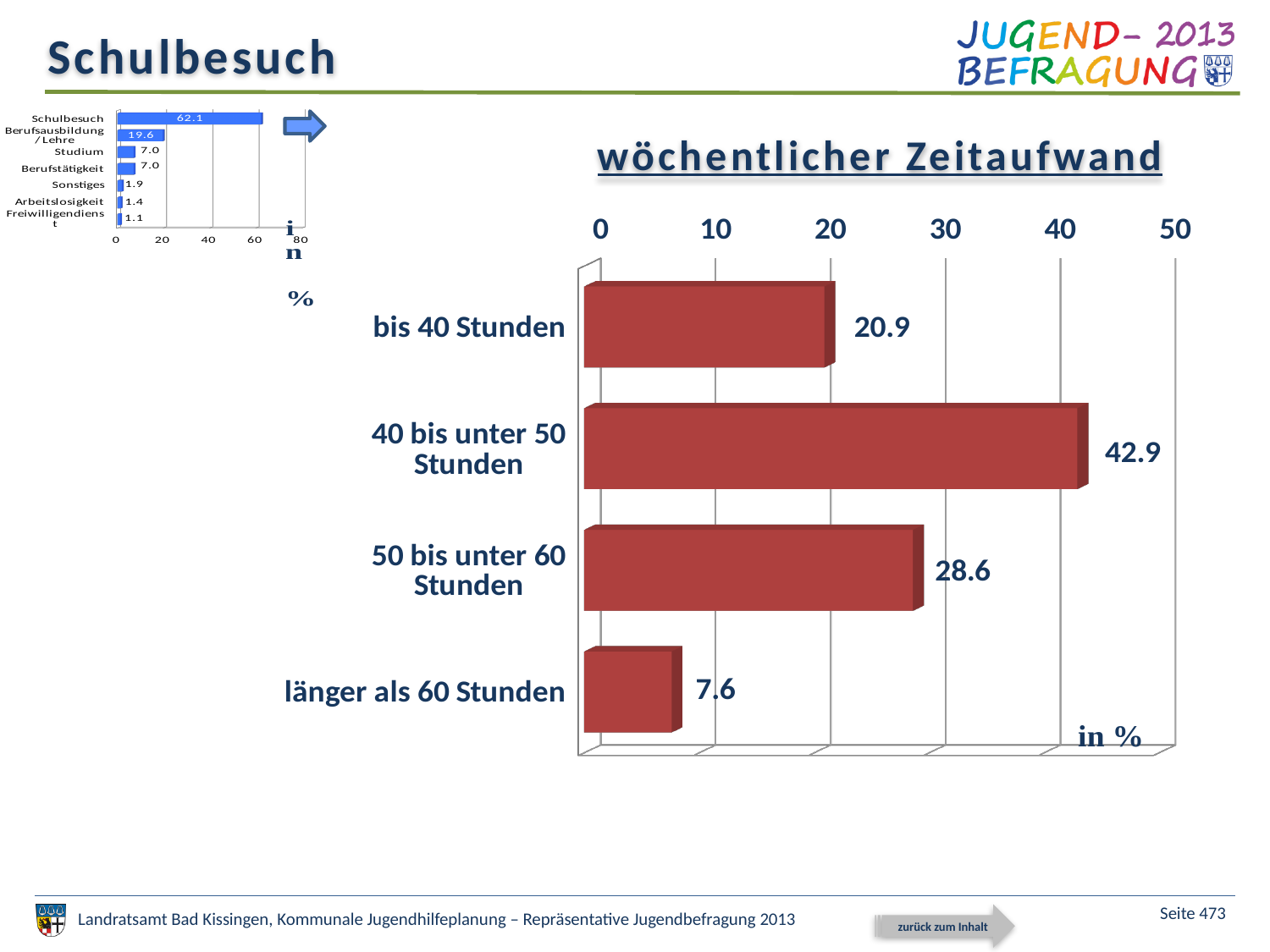
In the 'wöchentlicher Zeitaufwand' chart, what is the value for 'länger als 60 Stunden'? 7.6 In the 'wöchentlicher Zeitaufwand' chart, what is the value for '40 bis unter 50 Stunden'? 42.9 In the 'wöchentlicher Zeitaufwand' chart, which is larger: 'bis 40 Stunden' or '50 bis unter 60 Stunden'? 50 bis unter 60 Stunden In the small chart at the top left of the slide, what is the value for 'Berufsausbildung/Lehre'? 19.6 In the 'wöchentlicher Zeitaufwand' chart, which category has the lowest value? länger als 60 Stunden In the 'wöchentlicher Zeitaufwand' chart, what is the difference between '40 bis unter 50 Stunden' and '50 bis unter 60 Stunden'? 14.3 In the small chart at the top left of the slide, what is the value for 'Schulbesuch'? 62.1 In the small chart at the top left of the slide, how many categories are shown? 7 In the 'wöchentlicher Zeitaufwand' chart, which category has the highest value? 40 bis unter 50 Stunden In the 'wöchentlicher Zeitaufwand' chart, how many categories are shown? 4 In the small chart at the top left of the slide, what is the difference between 'Schulbesuch' and 'Berufsausbildung/Lehre'? 42.5 What kind of chart is the 'wöchentlicher Zeitaufwand' chart? bar chart